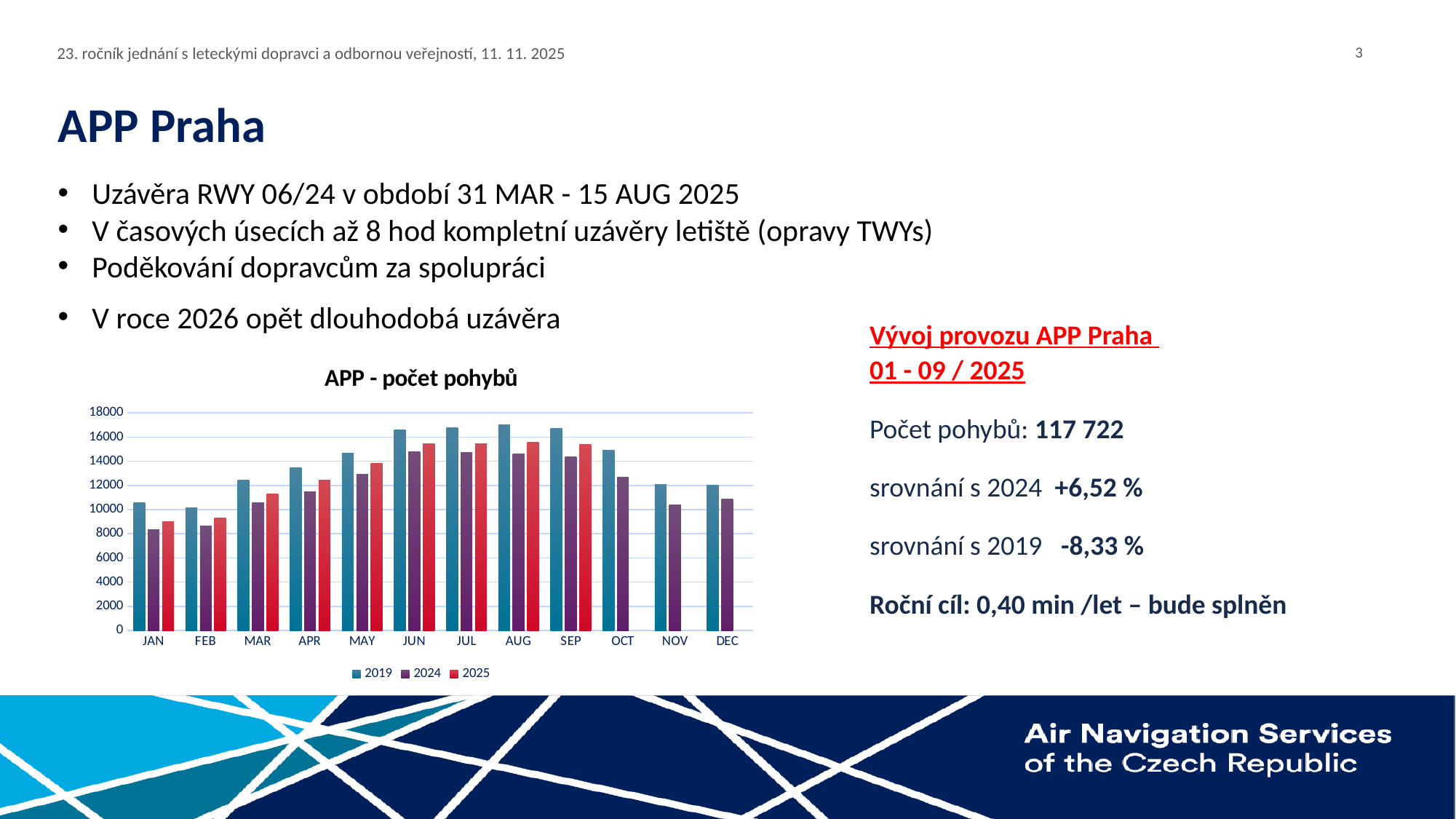
In JAN, which series has the larger value, 2019 or 2024? 2019 What is the title of the chart? APP - počet pohybů In JUN, which series has the larger value, 2024 or 2025? 2025 Is the value for 2024 in JAN greater or less than 10000? less Is the value for 2024 in OCT greater or less than 12000? greater How many months are shown on the x axis of the chart? 12 Which months have no bar for the 2025 series? OCT, NOV, DEC Is the value for 2025 in JUN greater or less than 14000? greater What kind of chart is shown on the slide? bar chart Do the 2019 values rise or fall from JAN to AUG? rise How many series does the legend of the chart list? 3